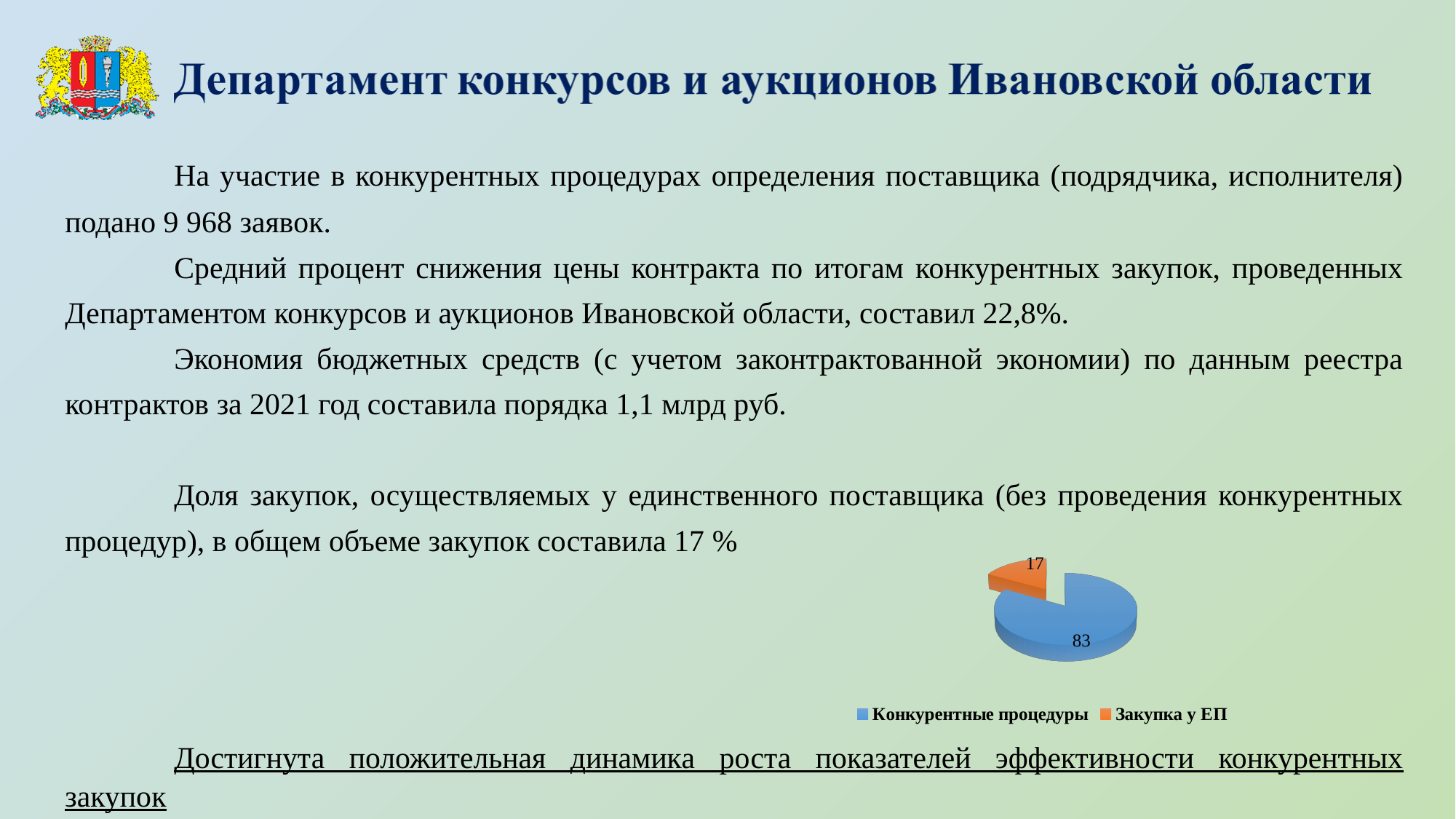
What share of the pie does Закупка у ЕП represent? 17% How many slices does the pie chart have? 2 What is the value shown for Закупка у ЕП in the pie chart? 17 What kind of chart is shown on the slide? pie chart Which category has the largest slice in the pie chart? Конкурентные процедуры What is the total of the two values shown in the pie chart? 100 Which category has the smallest slice in the pie chart? Закупка у ЕП How many entries does the legend of the pie chart list? 2 What is the difference between the values for Конкурентные процедуры and Закупка у ЕП in the pie chart? 66 What is the value shown for Конкурентные процедуры in the pie chart? 83 What colour is the Закупка у ЕП slice in the pie chart? orange Which is larger in the pie chart: Конкурентные процедуры or Закупка у ЕП? Конкурентные процедуры